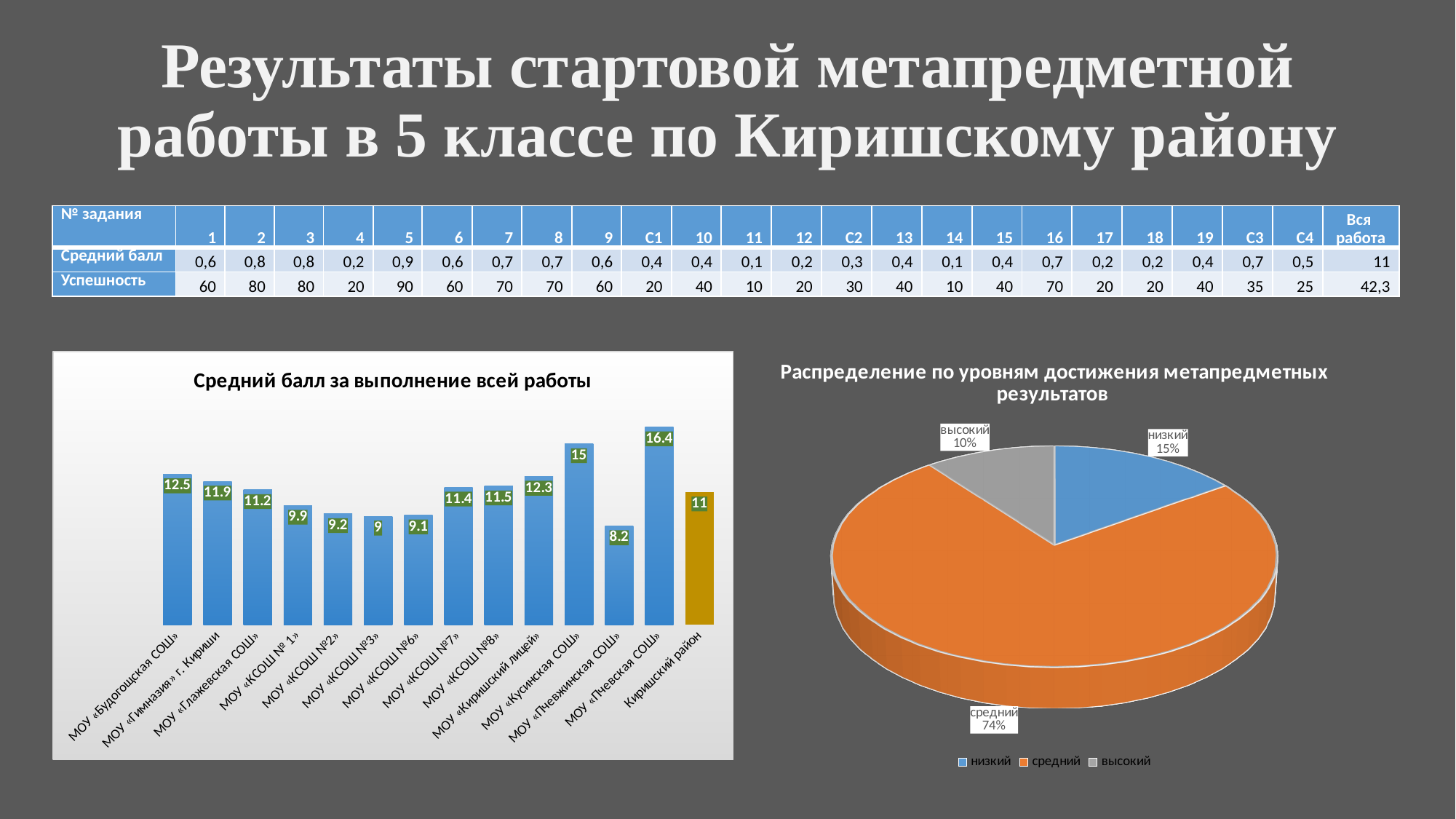
In the bar chart "Средний балл за выполнение всей работы", what is the value for Киришский район? 11 In the pie chart "Распределение по уровням достижения метапредметных результатов", which level has the smallest share? высокий In the bar chart "Средний балл за выполнение всей работы", which category has the highest value? МОУ «Пчевская СОШ» What kind of chart is "Средний балл за выполнение всей работы"? bar chart In the pie chart "Распределение по уровням достижения метапредметных результатов", what share does средний have? 74% In the bar chart "Средний балл за выполнение всей работы", what is the value for МОУ «Пчевская СОШ»? 16.4 In the bar chart "Средний балл за выполнение всей работы", which is larger: the value for МОУ «Будогощская СОШ» or МОУ «Гимназия» г. Кириши? МОУ «Будогощская СОШ» How many entries does the legend of the pie chart "Распределение по уровням достижения метапредметных результатов" list? 3 In the bar chart "Средний балл за выполнение всей работы", what is the difference between the values for МОУ «Кусинская СОШ» and МОУ «Пчевжинская СОШ»? 6.8 In the bar chart "Средний балл за выполнение всей работы", what colour is the bar for Киришский район? gold/yellow In the bar chart "Средний балл за выполнение всей работы", which category has the lowest value? МОУ «Пчевжинская СОШ» How many categories are shown in the bar chart "Средний балл за выполнение всей работы"? 14